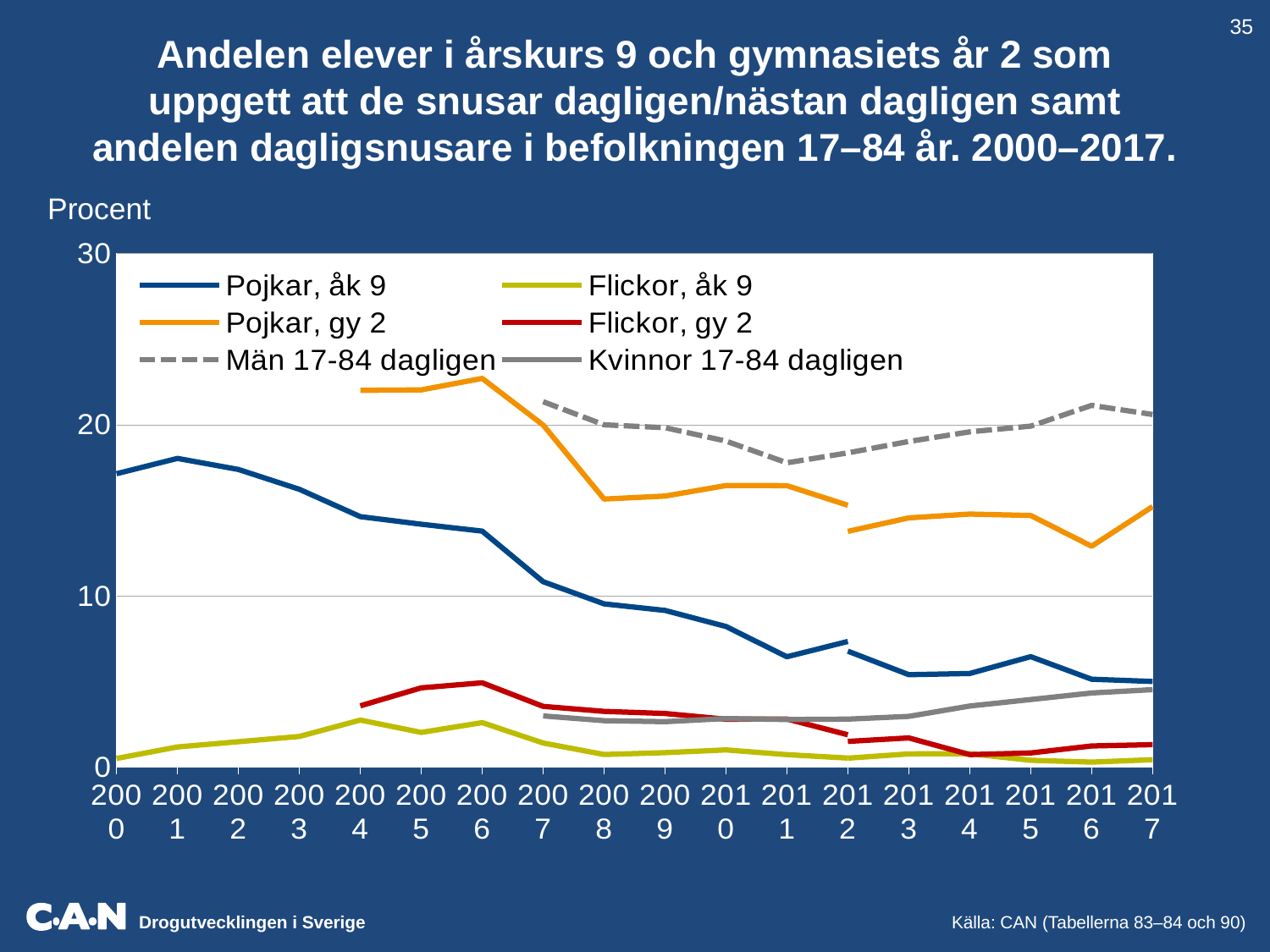
Is the value for Pojkar, åk 9 in 2000 greater or less than 10? greater What label is shown on the y axis of the chart? Procent How many years are shown along the x axis? 18 Which series has the highest value in 2017? Män 17-84 dagligen Does the value for Kvinnor 17-84 dagligen rise or fall from 2007 to 2017? rise How many series does the legend list? 6 Is the value for Män 17-84 dagligen in 2011 greater or less than 20? less Which series has the lowest value in 2017? Flickor, åk 9 Does the value for Pojkar, åk 9 rise or fall from 2000 to 2017? fall In 2010, which is larger: Pojkar, gy 2 or Pojkar, åk 9? Pojkar, gy 2 What kind of chart is shown on the slide? line chart Is the value for Pojkar, gy 2 in 2006 greater or less than 20? greater